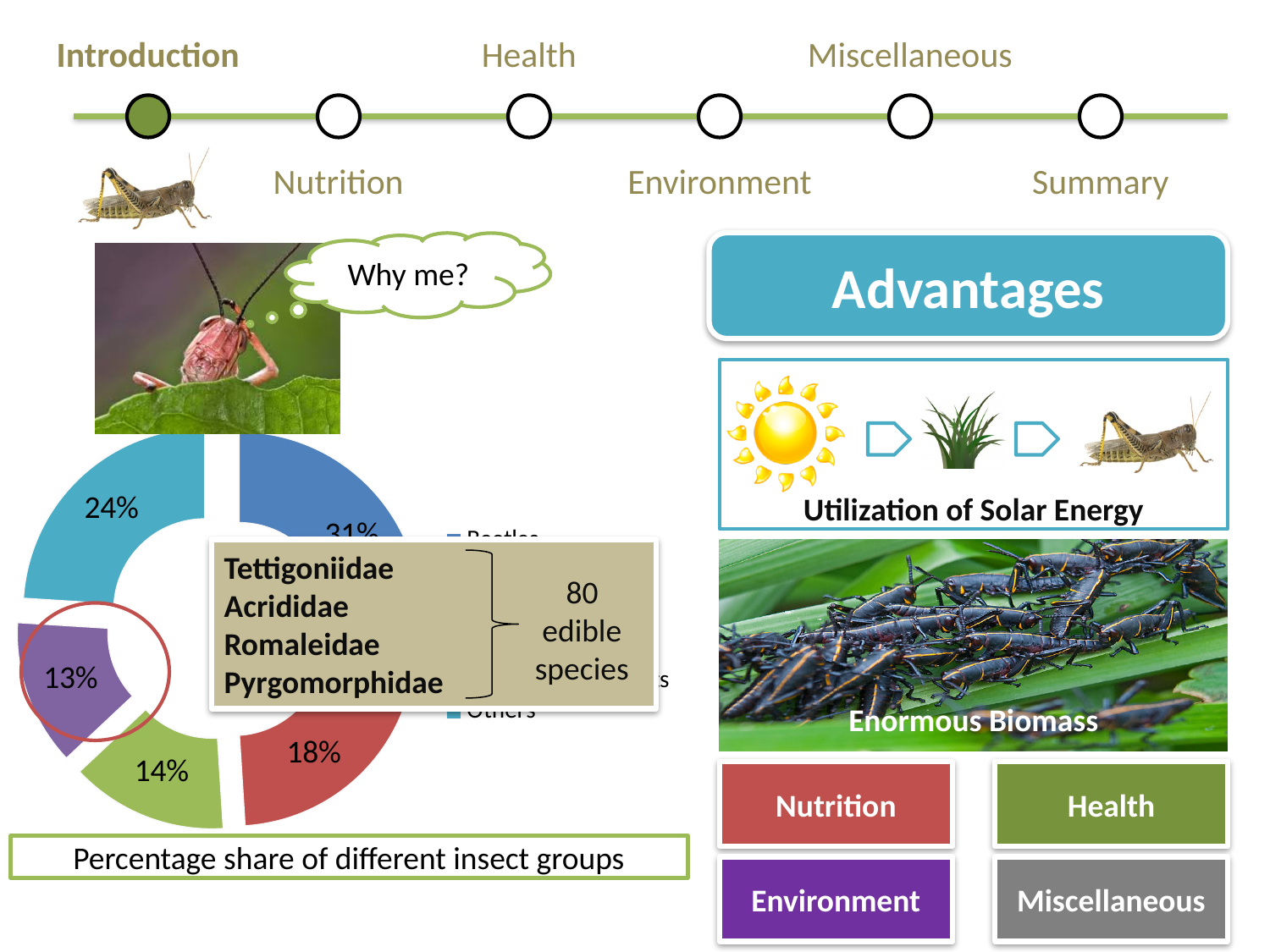
How many slices does the pie chart have? 5 Which slice of the pie chart has the smallest share? the purple slice (13%) What is the caption/title shown below the pie chart? Percentage share of different insect groups What percentage is shown on the dark blue slice of the pie chart? 31% What kind of chart is shown on the left of the slide? pie chart (doughnut) What is the difference in percentage points between the teal slice and the purple slice? 11 percentage points What percentage is shown on the purple slice that is circled in red? 13% What percentage is shown on the red slice of the pie chart? 18% What percentage is shown on the teal (light blue) slice of the pie chart? 24% Which slice of the pie chart has the largest share? the dark blue slice (31%) What percentage is shown on the green slice of the pie chart? 14% Which is larger, the share of the red slice or the share of the green slice? the red slice (18%)